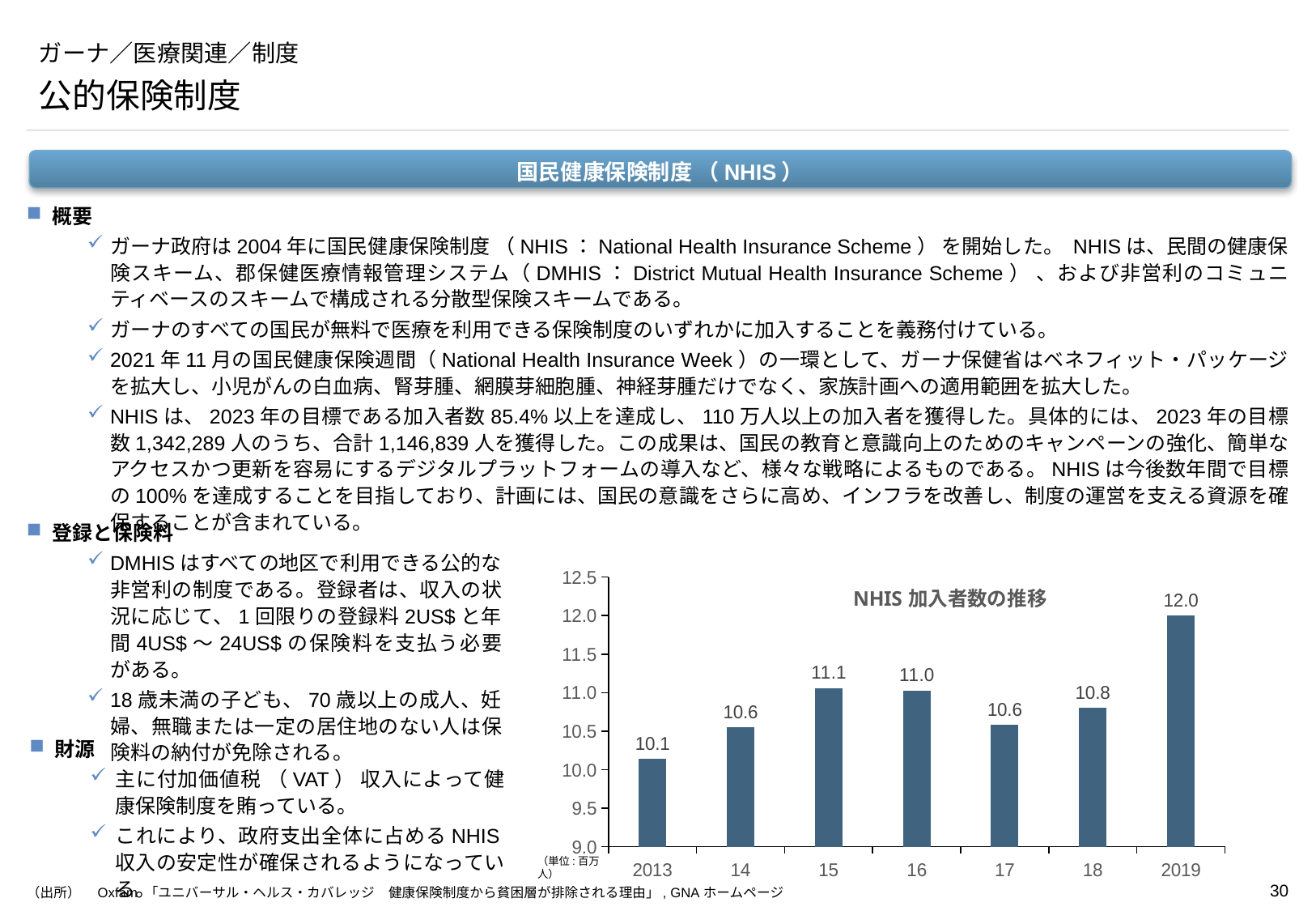
What type of chart is shown on the slide? bar chart Which year has the highest value in the NHIS 加入者数の推移 chart? 2019 What unit is indicated for the values in the NHIS 加入者数の推移 chart? 百万人 How many years are plotted in the NHIS 加入者数の推移 chart? 7 Which is larger in the NHIS 加入者数の推移 chart, the value for 2015 or the value for 2017? 2015 What is the value for 2013 in the NHIS 加入者数の推移 chart? 10.1 What is the value for 2019 in the NHIS 加入者数の推移 chart? 12.0 Which year has the lowest value in the NHIS 加入者数の推移 chart? 2013 What is the difference between the values for 2019 and 2013 in the NHIS 加入者数の推移 chart? 1.9 What is the value for 2018 in the NHIS 加入者数の推移 chart? 10.8 Is the value for 2016 in the NHIS 加入者数の推移 chart greater or less than 10.5? greater What is the title of the chart on the slide? NHIS 加入者数の推移